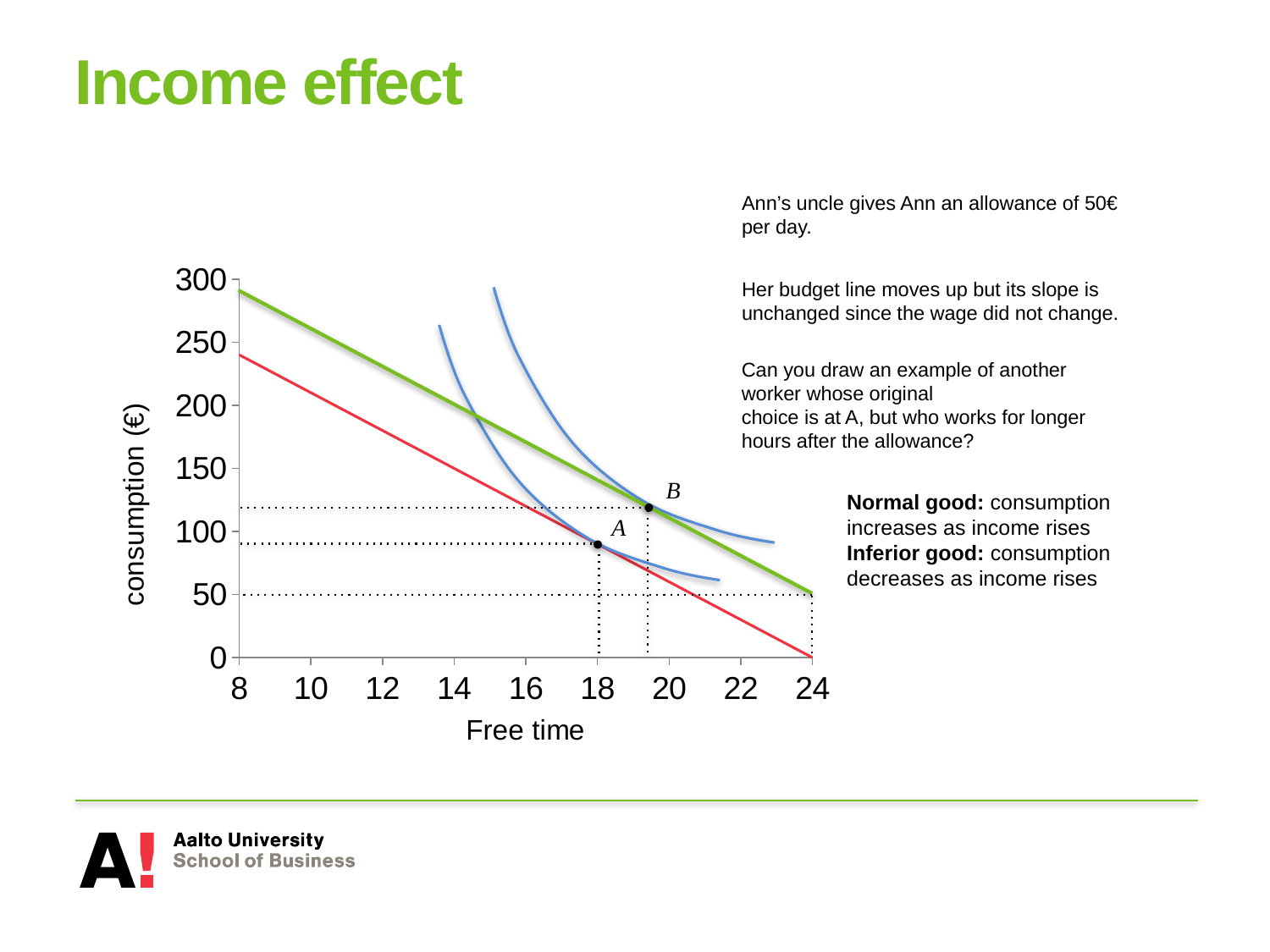
What is the consumption value of the green budget line at free time 24? 50 Which point has the higher consumption, A or B? B What is the label of the vertical axis? consumption (€) What is the label of the horizontal axis? Free time Is the consumption value of the red budget line at free time 8 greater or less than 200? greater What kind of chart is shown on the slide? line chart What is the consumption value where the red budget line meets the horizontal axis at free time 24? 0 What is the free time value at point A? 18 Do the budget lines rise or fall as free time increases? fall Is the consumption value at point A greater or less than 100? less How many labelled points are marked on the chart? 2 Is the consumption value at point B greater or less than 100? greater